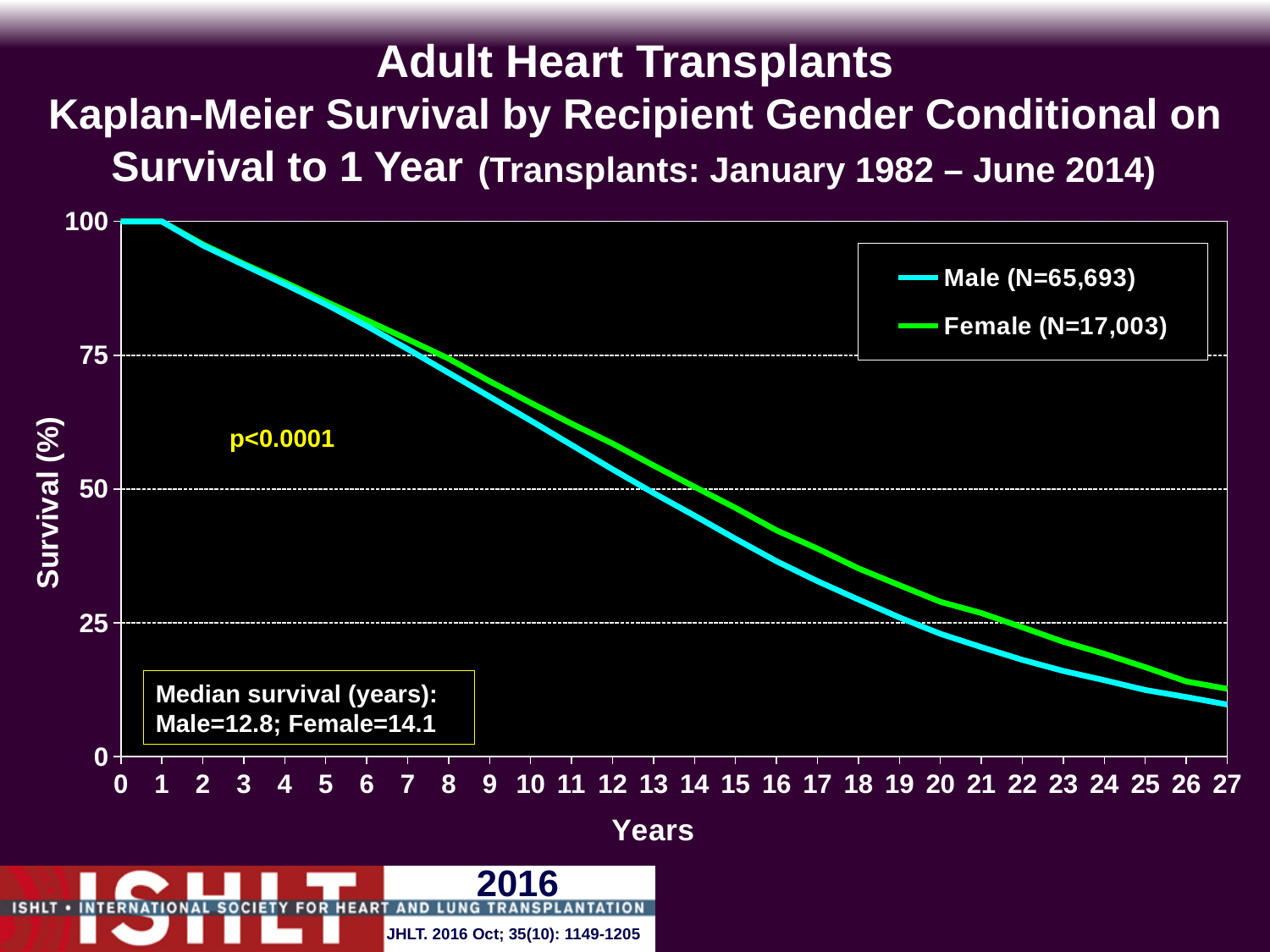
What is the number of female recipients (N) shown in the legend? 17,003 What is the number of male recipients (N) shown in the legend? 65,693 What is the median survival in years for male recipients? 12.8 Do the survival curves rise or fall as years increase? Fall Which group has the longer median survival, Male or Female? Female What kind of chart is shown on the slide? Line chart What is the median survival in years for female recipients? 14.1 Is the Female survival value at 10 years greater or less than 50? greater At 20 years, which curve shows higher survival, Male or Female? Female Is the Male survival value at 25 years greater or less than 25? less What p-value is shown on the chart? p<0.0001 How many series does the legend list? 2